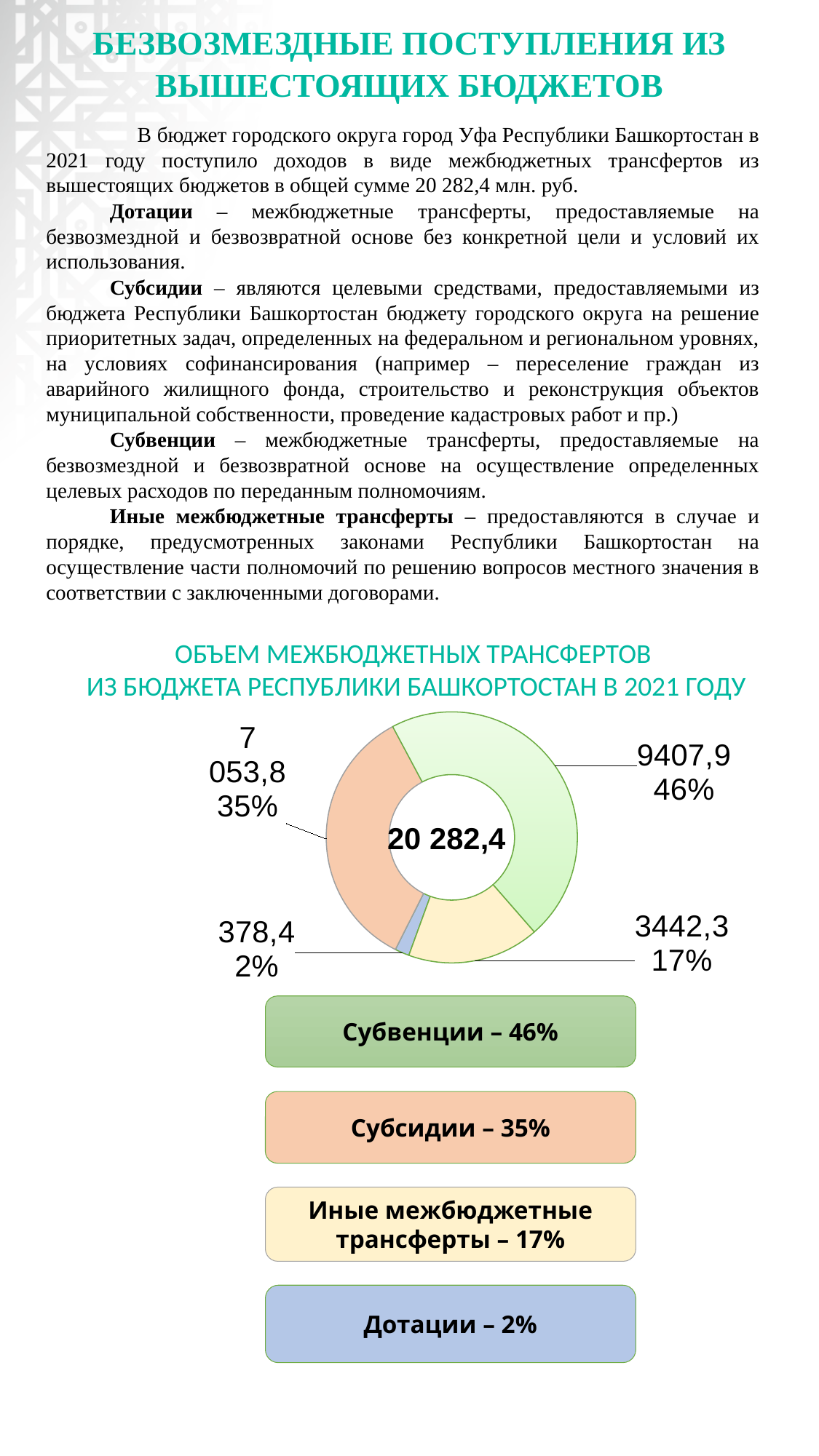
What is the value shown for Субсидии in the chart? 7 053,8 What is the value shown for Дотации in the chart? 378,4 What type of chart is shown on the slide? Pie (donut) chart What total value is shown in the centre of the donut chart? 20 282,4 Which category has the smallest slice in the chart? Дотации What is the value shown for Иные межбюджетные трансферты in the chart? 3442,3 What is the difference between the values for Субвенции and Субсидии? 2354,1 What share of the total do Субвенции make up? 46% Which category has the largest slice in the chart? Субвенции What is the value shown for Субвенции in the chart? 9407,9 How many slices does the donut chart have? 4 What share of the total do Дотации make up? 2%